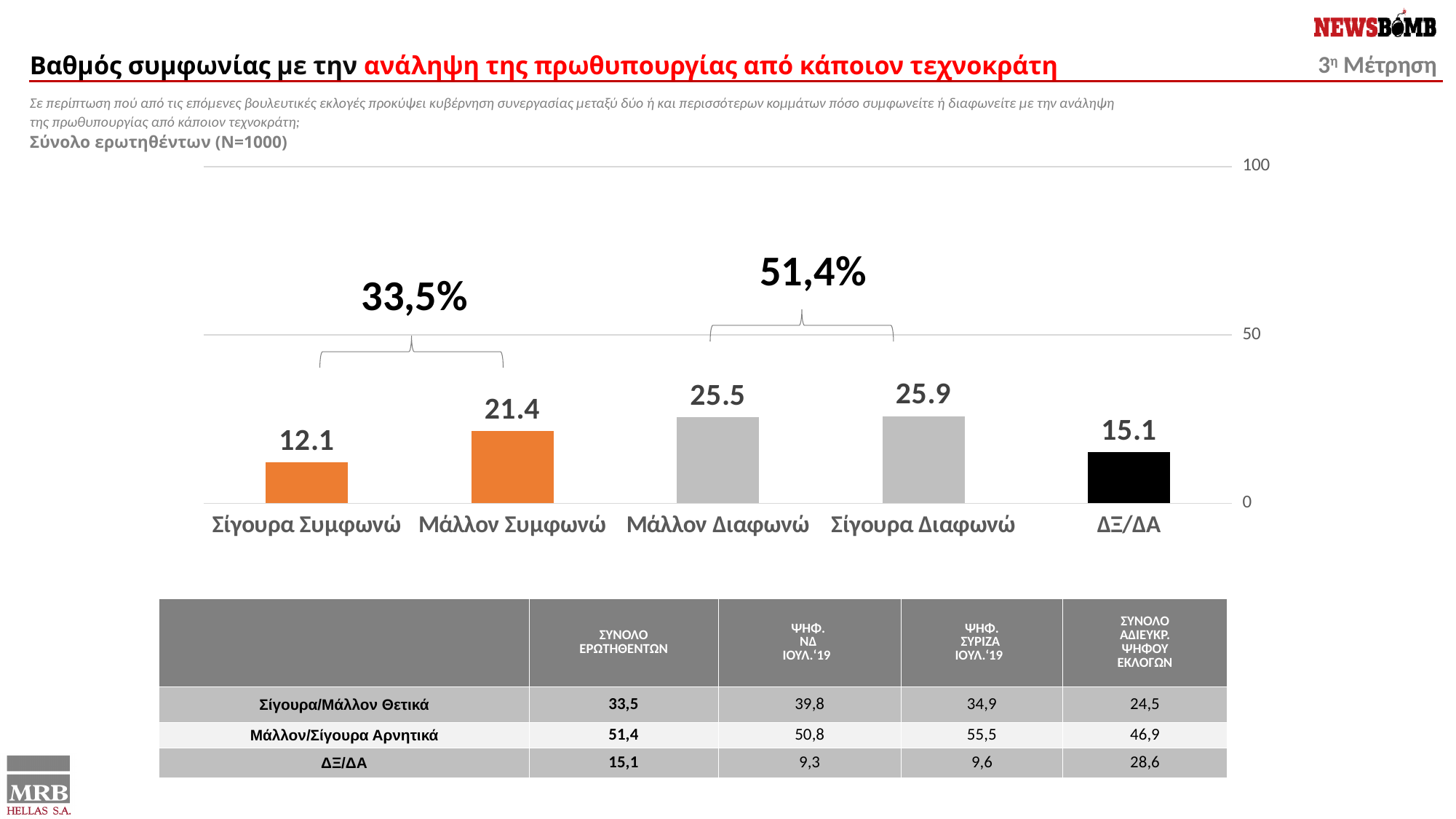
What is the value for Μάλλον Συμφωνώ? 21.4 What is the value for ΔΞ/ΔΑ? 15.1 How many categories are shown on the x axis of the chart? 5 Is the value for Σίγουρα Διαφωνώ greater or less than 50? less What combined percentage is shown above the two grey bars (Μάλλον Διαφωνώ and Σίγουρα Διαφωνώ)? 51,4% What is the value for Σίγουρα Διαφωνώ? 25.9 What is the difference between the values for Μάλλον Συμφωνώ and Σίγουρα Συμφωνώ? 9.3 Which is larger, the value for Μάλλον Διαφωνώ or the value for ΔΞ/ΔΑ? Μάλλον Διαφωνώ What is the value for Σίγουρα Συμφωνώ? 12.1 What kind of chart is shown on the slide? bar chart What combined percentage is shown above the two orange bars (Σίγουρα Συμφωνώ and Μάλλον Συμφωνώ)? 33,5% Which category has the lowest value? Σίγουρα Συμφωνώ